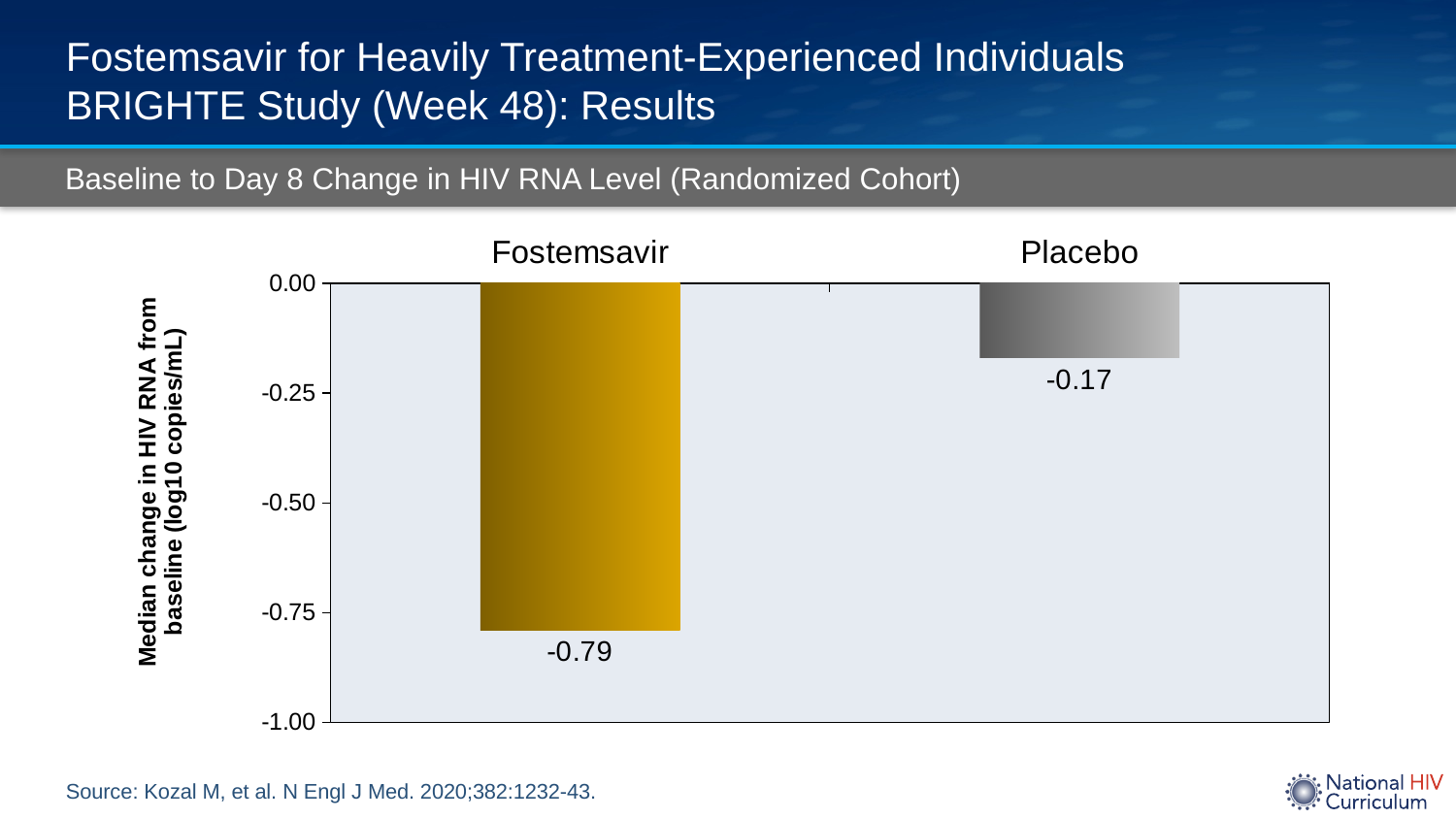
Which group shows the smaller decrease in HIV RNA from baseline? Placebo What is the median change in HIV RNA from baseline for Placebo? -0.17 What kind of chart is shown on the slide? Bar chart What is the difference between the Fostemsavir and Placebo median changes in HIV RNA? 0.62 What is the title of the chart? Baseline to Day 8 Change in HIV RNA Level (Randomized Cohort) Is the value for Fostemsavir greater or less than -0.50? less Which group shows the larger decrease in HIV RNA from baseline? Fostemsavir How many groups are plotted in the chart? 2 What is the label of the y axis? Median change in HIV RNA from baseline (log10 copies/mL) What is the median change in HIV RNA from baseline for Fostemsavir? -0.79 Is the decrease in HIV RNA larger for Fostemsavir or for Placebo? Fostemsavir Is the value for Placebo greater or less than -0.25? greater